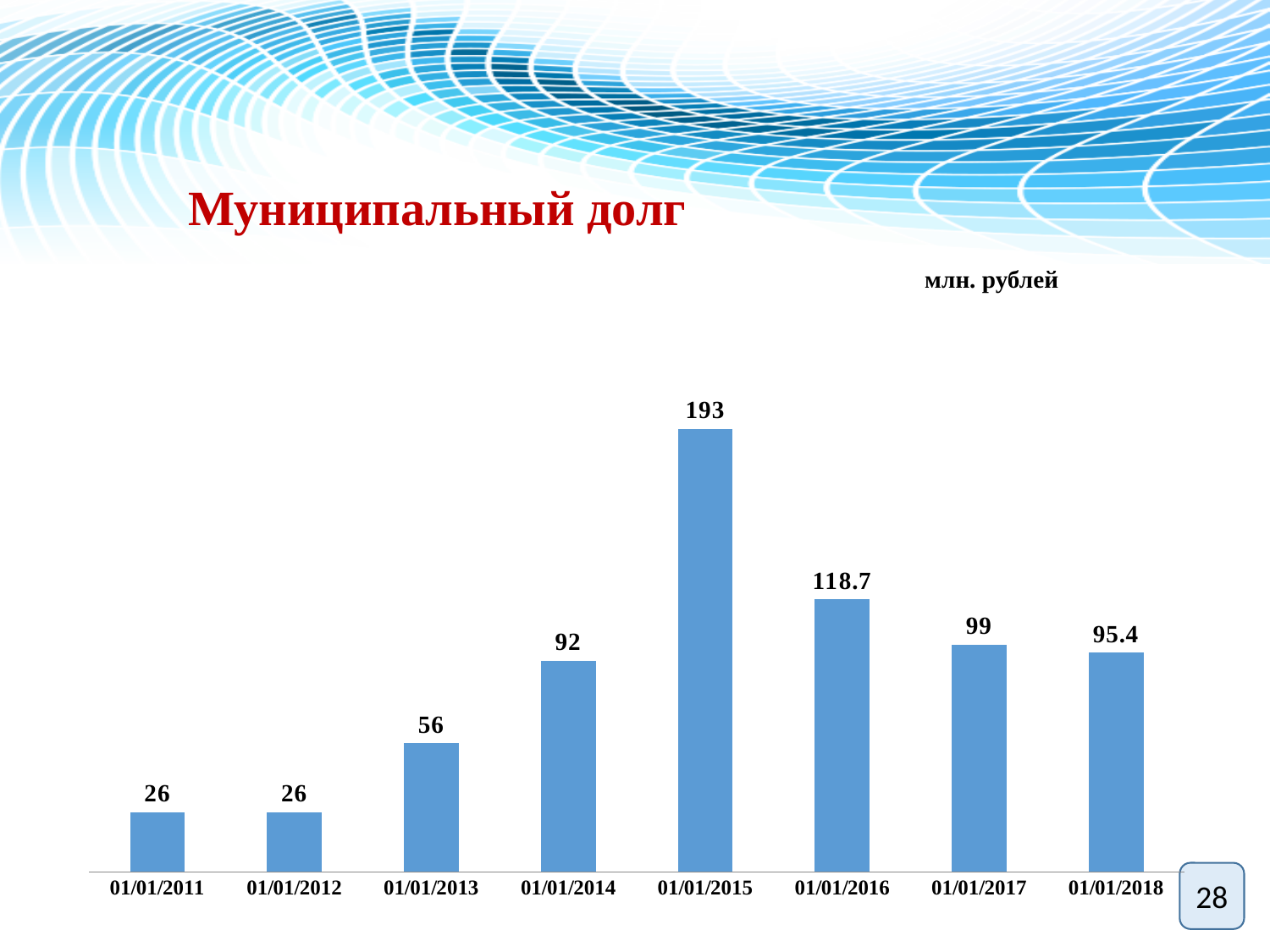
What is the lowest value shown on the chart? 26 Which is larger, the value for 01/01/2017 or the value for 01/01/2018? 01/01/2017 What kind of chart is shown on the slide? Bar chart Which date has the highest municipal debt value? 01/01/2015 What is the municipal debt value shown for 01/01/2015? 193 What is the difference between the values for 01/01/2015 and 01/01/2016? 74.3 What is the difference between the values for 01/01/2014 and 01/01/2013? 36 What is the title of the chart on the slide? Муниципальный долг How many dates (bars) are shown on the chart? 8 What is the value shown for 01/01/2016? 118.7 What is the value shown for 01/01/2018? 95.4 Do the values rise or fall from 01/01/2015 to 01/01/2018? Fall